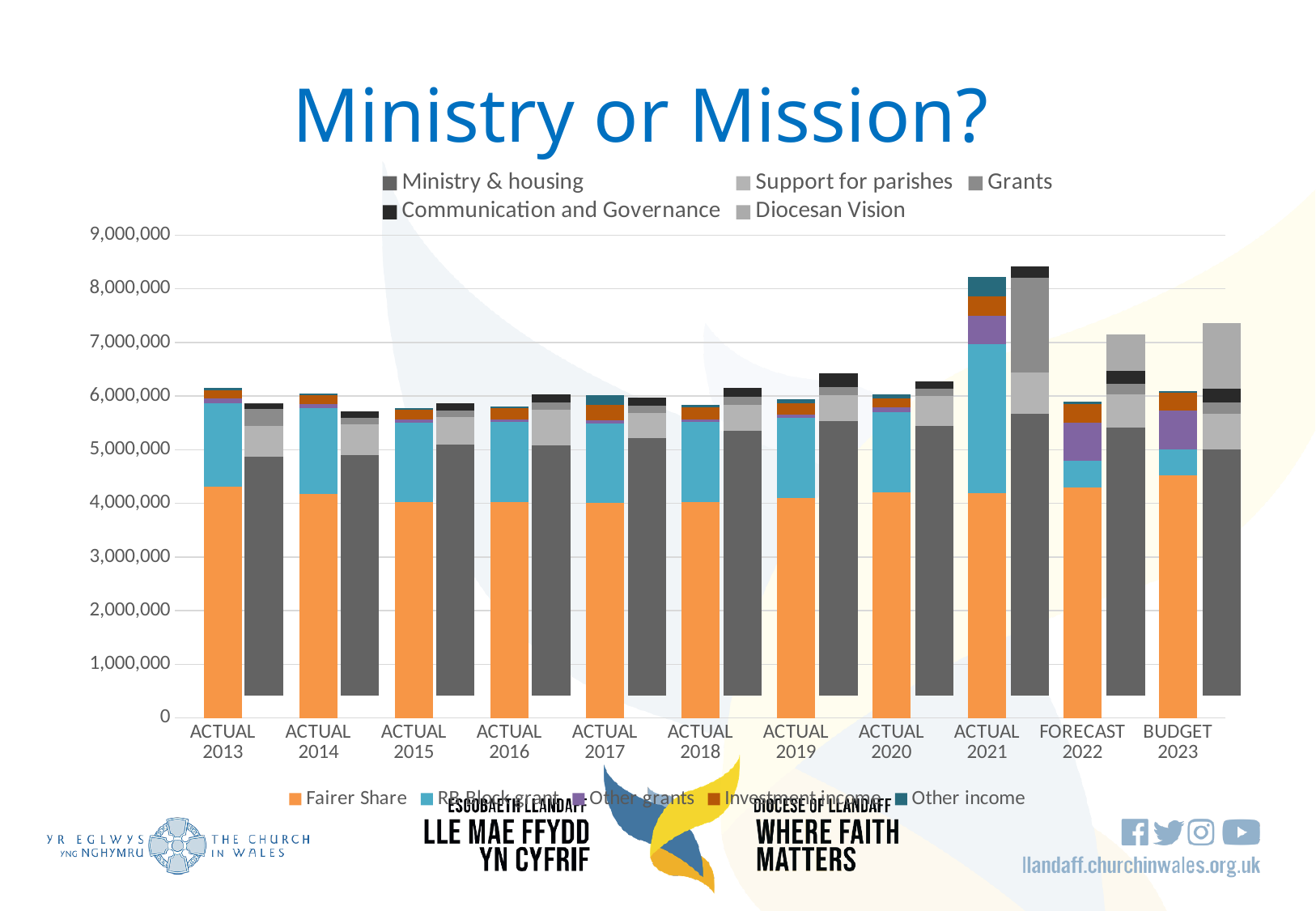
What is the title of the chart on the slide? Ministry or Mission? How many series are listed in the legend above the chart? 5 What kind of chart is shown on the slide? Stacked bar chart Which is taller: the expenditure bar (the one starting with Ministry & housing) for BUDGET 2023 or for ACTUAL 2013? BUDGET 2023 How many year categories are shown along the x axis of the chart? 11 What colour represents Fairer Share in the chart? Orange What is the highest value shown on the y axis of the chart? 9,000,000 Which year has the tallest bars in the chart? ACTUAL 2021 Is the total of the income bar (the one starting with Fairer Share) for ACTUAL 2015 greater or less than 6,000,000? less Is the total of the income bar (the one starting with Fairer Share) for ACTUAL 2021 greater or less than 8,000,000? greater How many series are listed in the legend below the chart? 5 Is the Fairer Share segment for ACTUAL 2013 greater or less than 4,000,000? greater